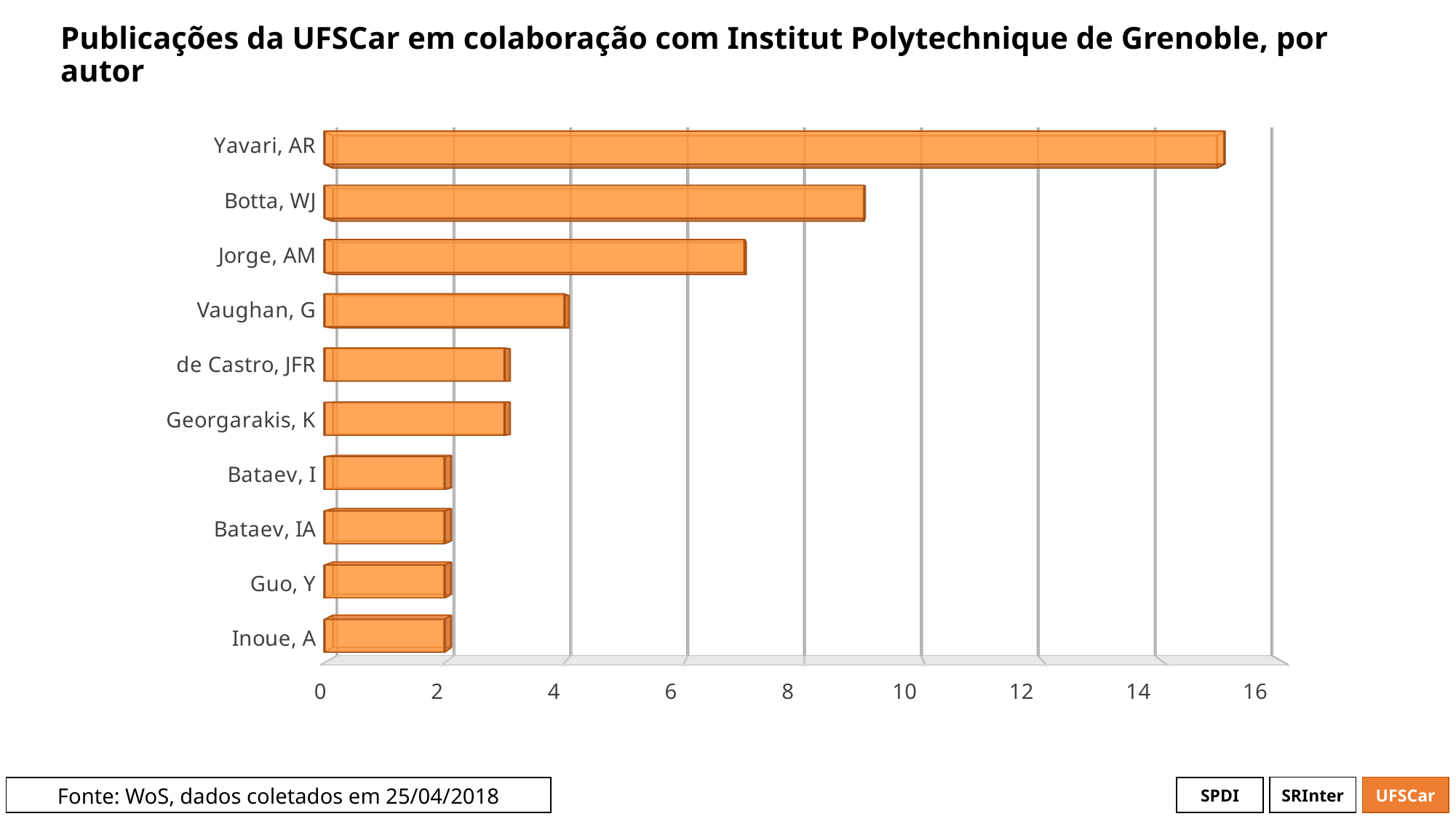
Who has more publications, Vaughan, G or Georgarakis, K? Vaughan, G Is the value for Jorge, AM greater or less than 8? less Is the value for Inoue, A greater or less than 4? less Is the value for de Castro, JFR greater or less than 4? less What is the title of the chart? Publicações da UFSCar em colaboração com Institut Polytechnique de Grenoble, por autor What kind of chart is shown on the slide? bar chart Who has more publications, Botta, WJ or Jorge, AM? Botta, WJ How many authors are listed in the chart? 10 Which author has the highest number of publications? Yavari, AR